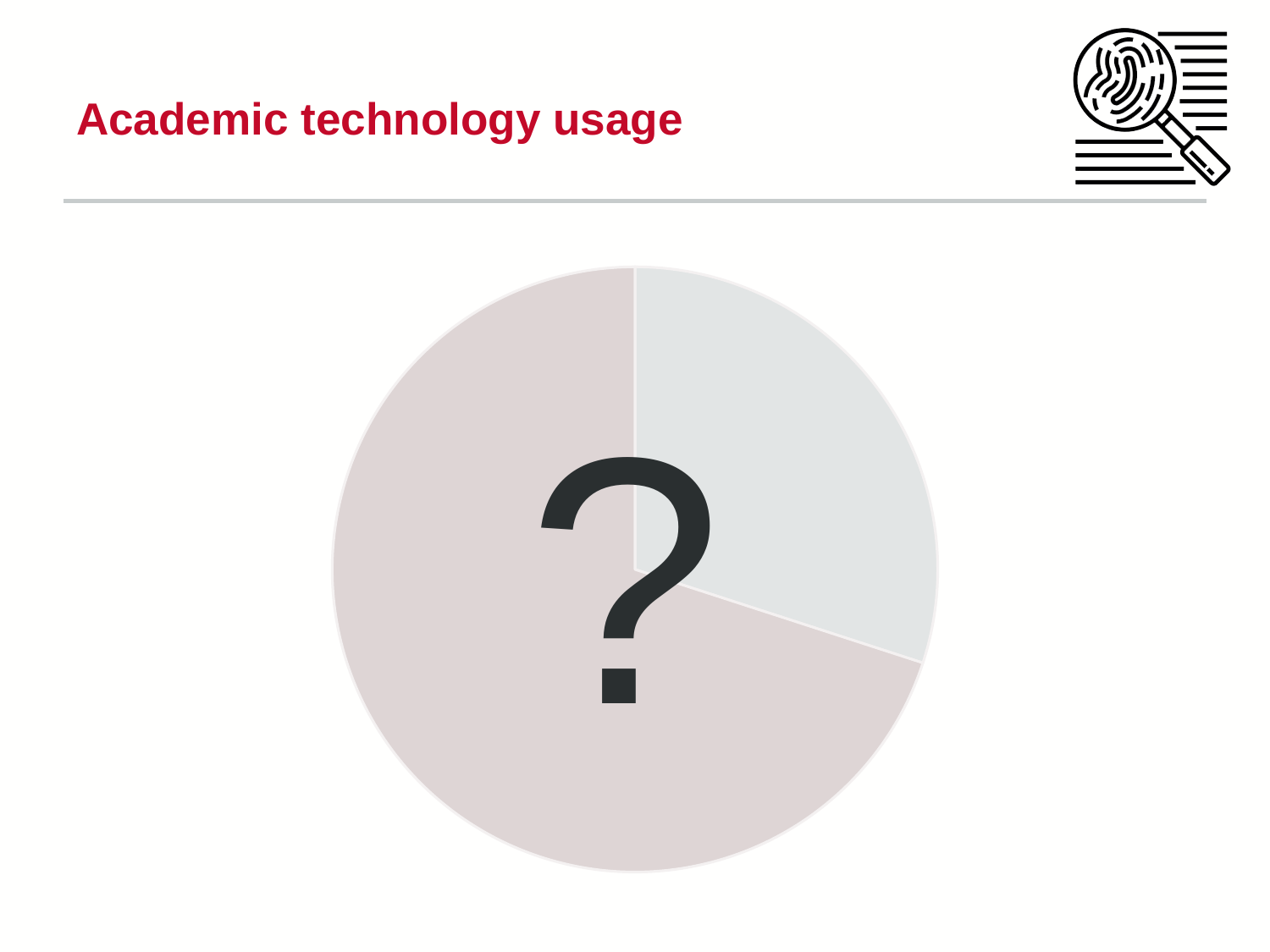
Which slice of the pie chart is larger, the pinkish-grey slice or the light blue-grey slice? the pinkish-grey slice How many slices does the pie chart have? 2 What kind of chart is shown on the slide? pie chart Does the pie chart display any data labels or a legend? No What is the title of the slide containing the pie chart? Academic technology usage